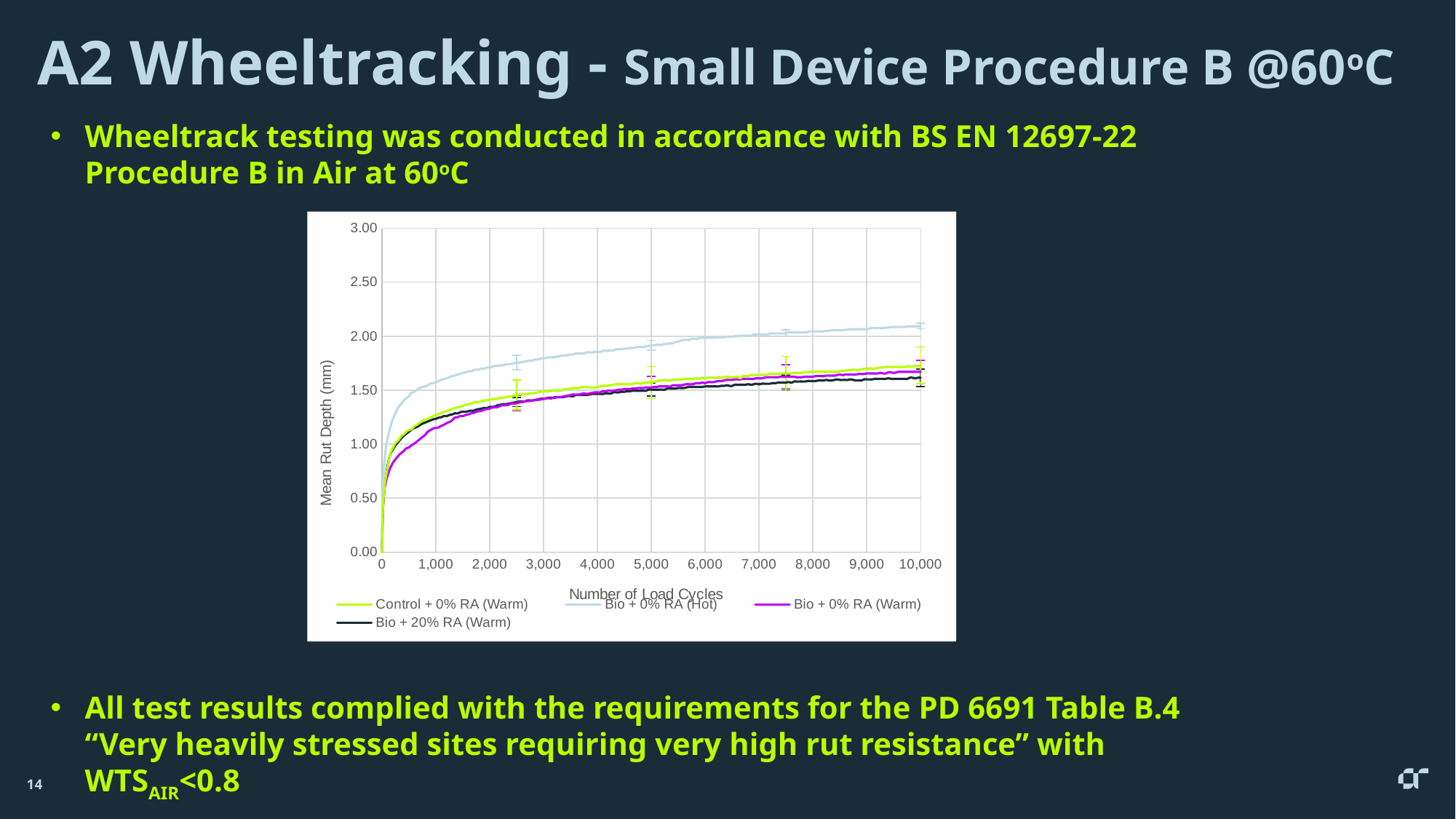
Do the mean rut depth values rise or fall as the number of load cycles increases? Rise Is the mean rut depth for Bio + 0% RA (Hot) at 5,000 load cycles greater or less than 1.50? greater Is the mean rut depth for Bio + 20% RA (Warm) at 10,000 load cycles greater or less than 1.50? greater Is the mean rut depth for Bio + 0% RA (Hot) at 10,000 load cycles greater or less than 2.00? greater How many series does the chart legend list? 4 What is the label of the chart's horizontal axis? Number of Load Cycles At 10,000 load cycles, which has the larger mean rut depth: Bio + 0% RA (Hot) or Bio + 20% RA (Warm)? Bio + 0% RA (Hot) What kind of chart is shown on the slide? Line chart What is the label of the chart's vertical axis? Mean Rut Depth (mm) Which series has the highest mean rut depth at 10,000 load cycles? Bio + 0% RA (Hot)